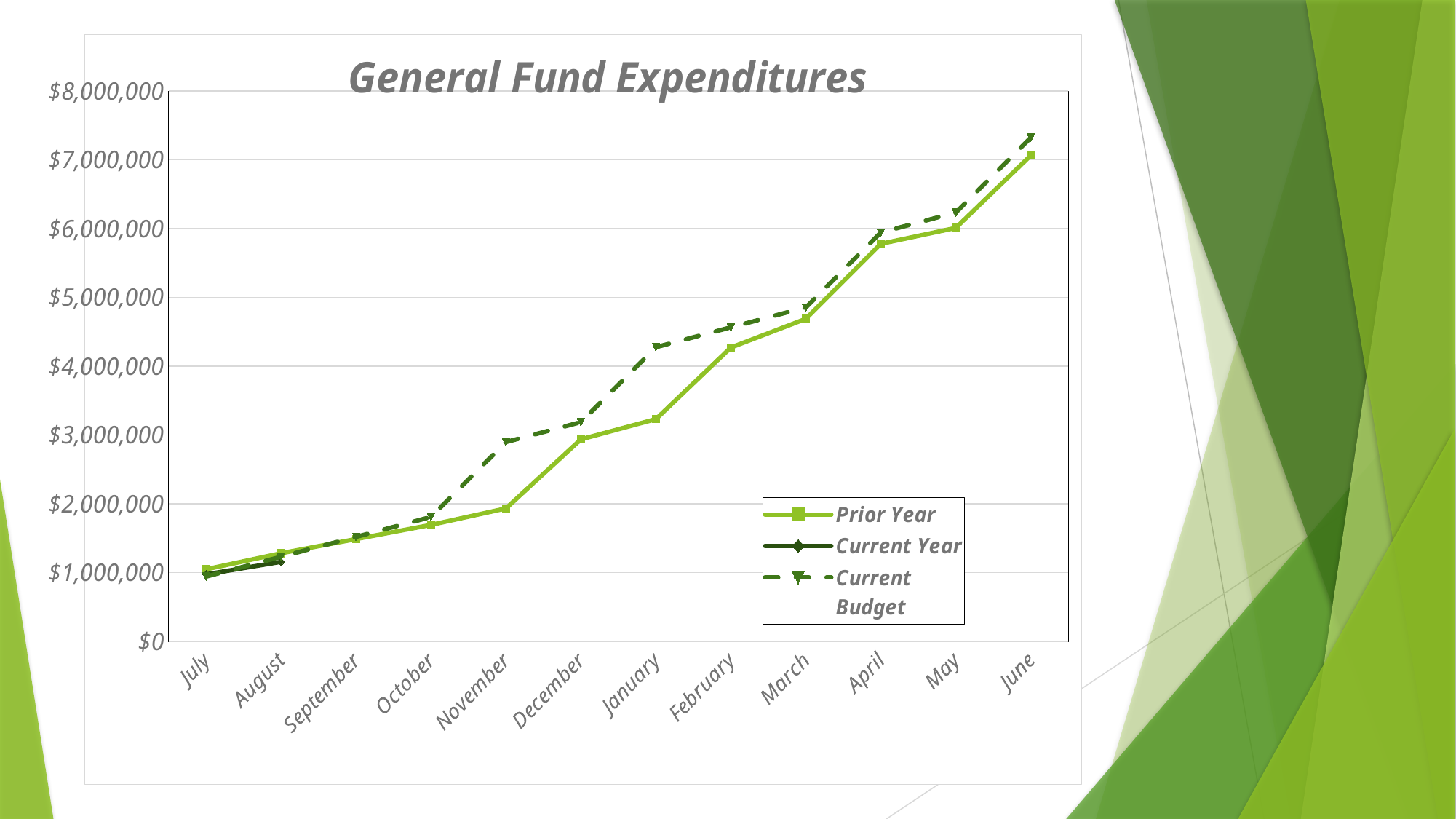
What kind of chart is shown on the slide? line chart Which series is drawn with a dashed line? Current Budget Is the Prior Year value for April greater or less than $6,000,000? less Do the Prior Year values rise or fall from July to June? rise What is the title of the chart? General Fund Expenditures Is the Current Budget value for June greater or less than $7,000,000? greater How many series does the legend list? 3 In January, which is larger: the Current Budget value or the Prior Year value? Current Budget Is the Current Budget value for January greater or less than $4,000,000? greater In which month is the Prior Year value highest? June How many months are shown along the x axis? 12